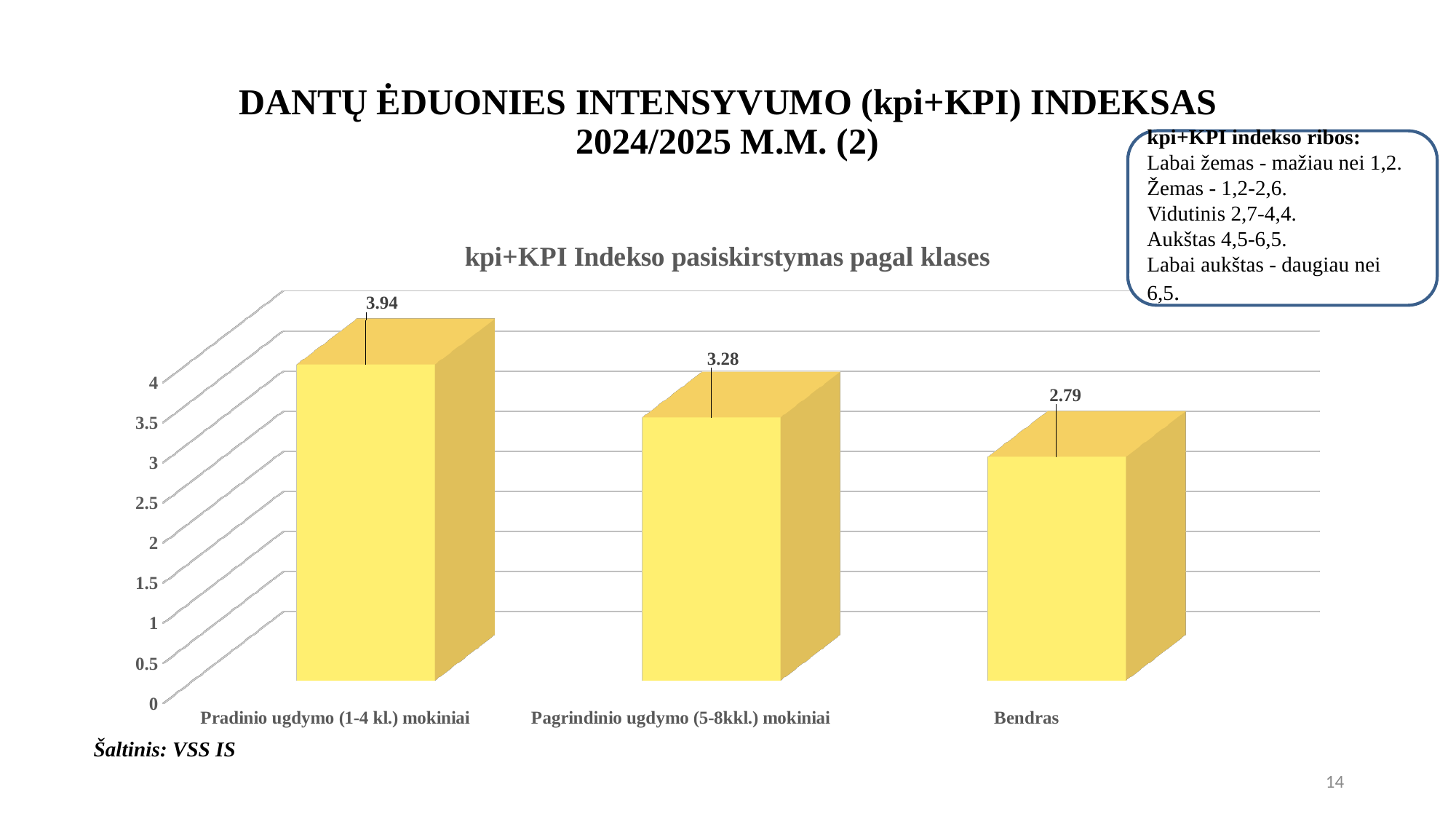
Which is larger, the value for Pagrindinio ugdymo (5-8kkl.) mokiniai or the value for Bendras? Pagrindinio ugdymo (5-8kkl.) mokiniai What is the title of the chart? kpi+KPI Indekso pasiskirstymas pagal klases What is the difference between the values for Pradinio ugdymo (1-4 kl.) mokiniai and Pagrindinio ugdymo (5-8kkl.) mokiniai? 0.66 What is the value for Pradinio ugdymo (1-4 kl.) mokiniai? 3.94 Which category has the lowest value? Bendras What is the value for Bendras? 2.79 What kind of chart is shown on the slide? bar chart Is the value for Bendras greater or less than 3? less What is the value for Pagrindinio ugdymo (5-8kkl.) mokiniai? 3.28 How many categories are shown in the chart? 3 What is the difference between the values for Pradinio ugdymo (1-4 kl.) mokiniai and Bendras? 1.15 Which category has the highest value? Pradinio ugdymo (1-4 kl.) mokiniai